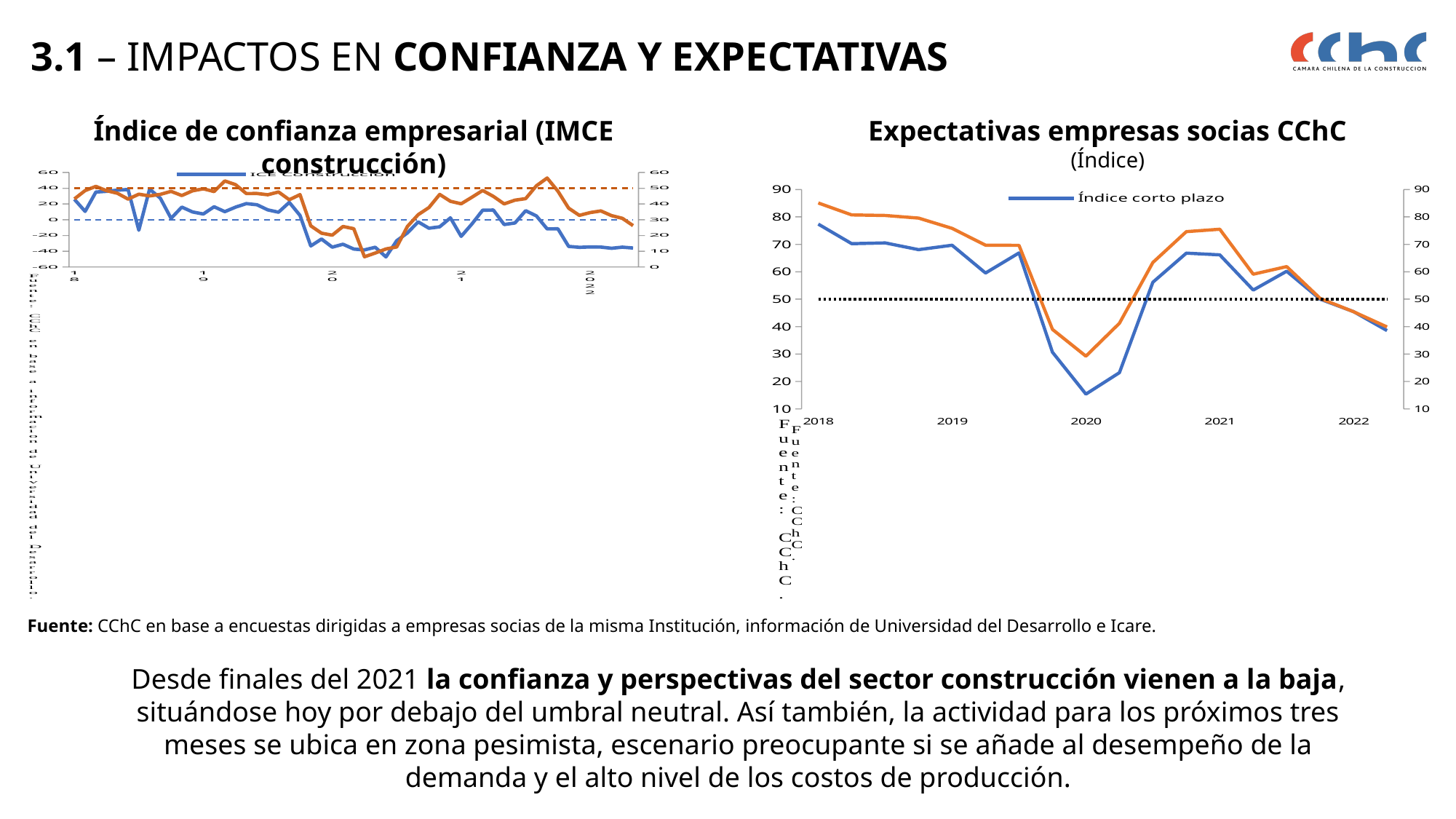
In the 'Expectativas empresas socias CChC' chart, is the value of the orange line at the start of 2018 greater or less than 80? greater In the 'Expectativas empresas socias CChC' chart, do the lines rise or fall between 2021 and 2022? fall In the 'Expectativas empresas socias CChC' chart, is the lowest point of the orange line in 2020 greater or less than 40? less In the 'Expectativas empresas socias CChC' chart, is the value of the blue line at the start of 2018 greater or less than 70? greater What kind of chart is the 'Índice de confianza empresarial (IMCE construcción)' chart on the left? line chart In the 'Expectativas empresas socias CChC' chart, which line is higher at the start of 2018, the orange line or the blue line? the orange line In the 'Expectativas empresas socias CChC' chart, at what value is the dotted horizontal line drawn? 50 What kind of chart is the 'Expectativas empresas socias CChC' chart on the right? line chart What series name is shown in the legend of the 'Expectativas empresas socias CChC' chart? Índice corto plazo In the 'Expectativas empresas socias CChC' chart, in which year do both lines reach their lowest point? 2020